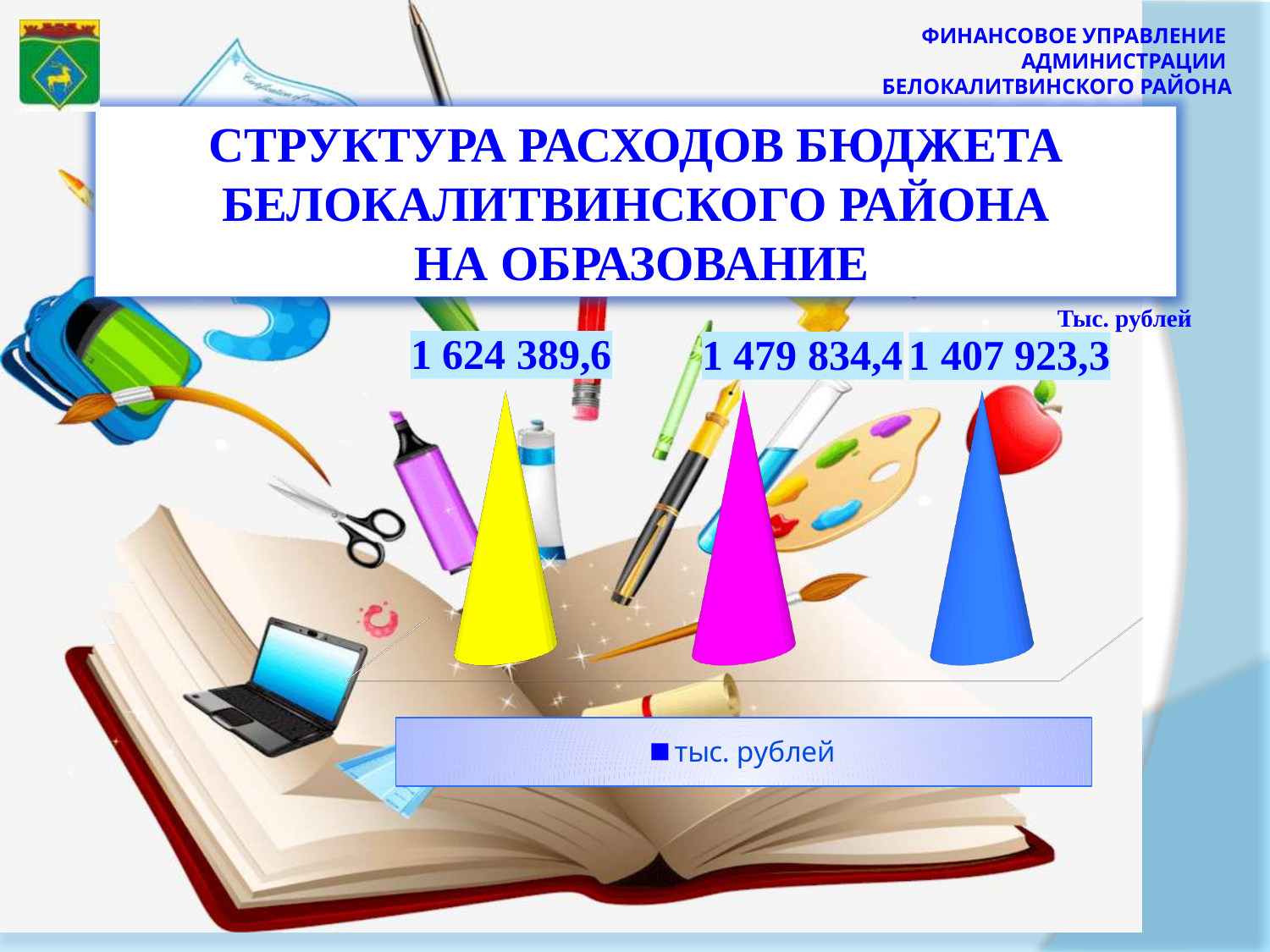
What value is shown above the blue (rightmost) cone? 1 407 923,3 What is the difference between the values of the magenta cone and the blue cone? 71 911,1 Which cone has the highest value? The yellow (leftmost) cone What is the legend entry of the chart? тыс. рублей How many series does the legend list? 1 What value is shown above the magenta (middle) cone? 1 479 834,4 Which cone has the lowest value? The blue (rightmost) cone How many cones (data points) are plotted in the chart? 3 What is the difference between the values of the yellow cone and the magenta cone? 144 555,2 Which is larger, the value of the magenta cone or the value of the blue cone? The magenta cone What value is shown above the yellow (leftmost) cone? 1 624 389,6 Do the values rise or fall from left to right across the chart? Fall